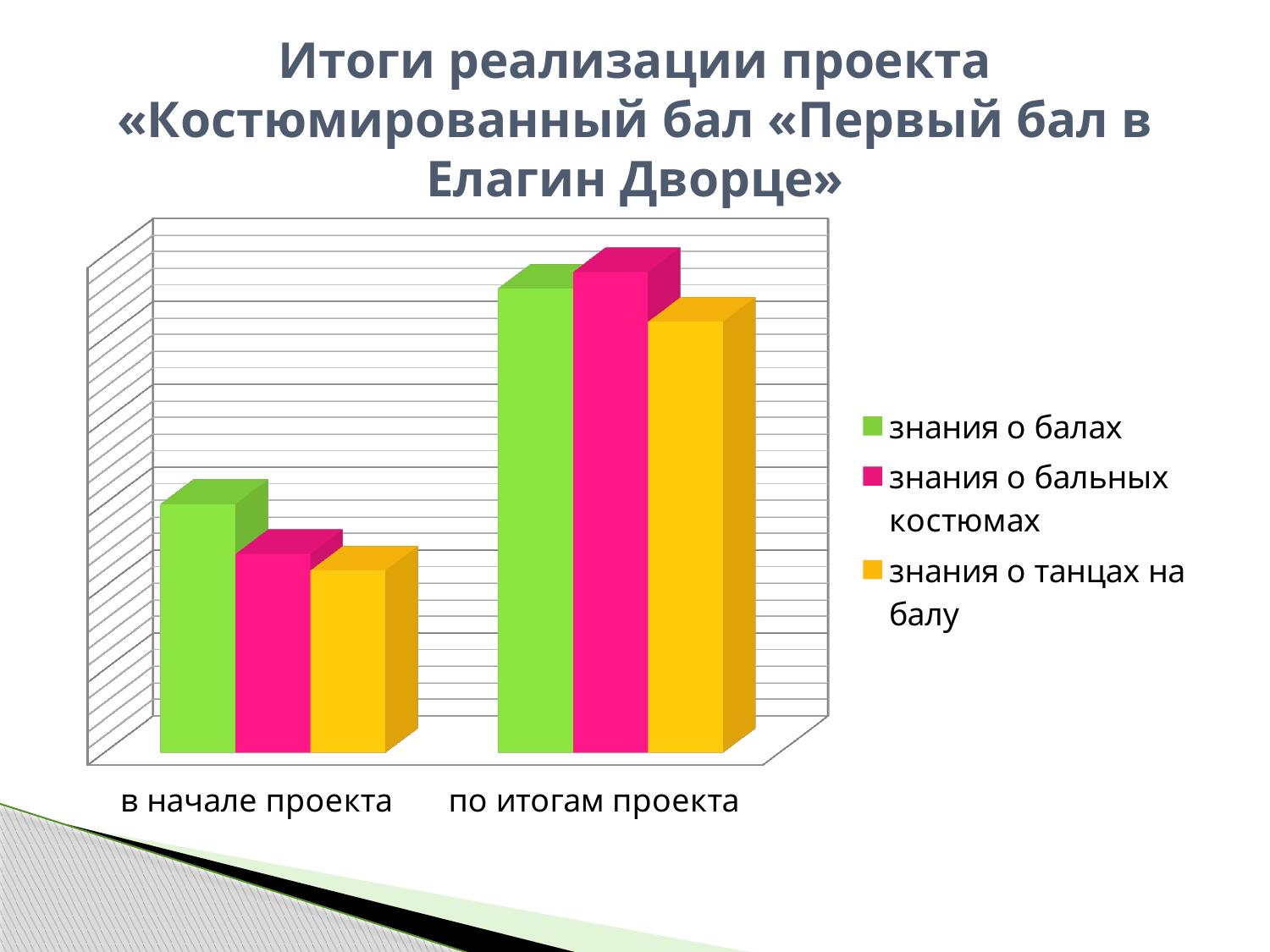
What kind of chart is shown on the slide? bar chart What colour represents the series "знания о танцах на балу" in the chart? yellow Which series has the lowest bar in the category "по итогам проекта"? знания о танцах на балу For the series "знания о балах", which category has the larger value: "в начале проекта" or "по итогам проекта"? по итогам проекта Do the values for the series "знания о бальных костюмах" rise or fall from "в начале проекта" to "по итогам проекта"? rise How many categories are shown on the x axis of the chart? 2 Which series is shown in pink in the chart? знания о бальных костюмах Which series has the highest bar in the category "в начале проекта"? знания о балах Which series has the highest bar in the category "по итогам проекта"? знания о бальных костюмах How many series does the chart's legend list? 3 For the series "знания о танцах на балу", is the value larger in "в начале проекта" or in "по итогам проекта"? по итогам проекта In the category "в начале проекта", which is larger: "знания о балах" or "знания о бальных костюмах"? знания о балах